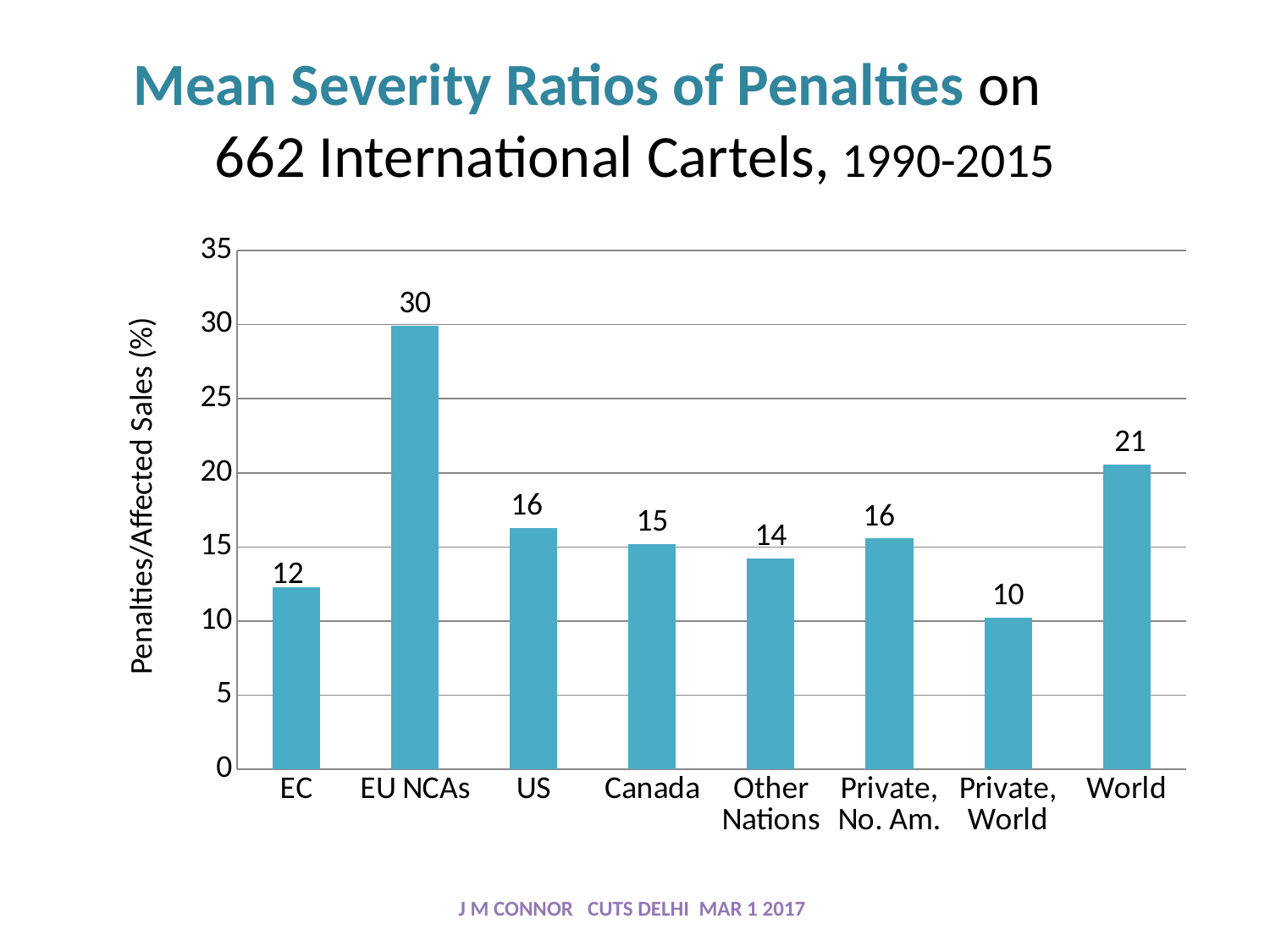
Which category has the highest mean severity ratio? EU NCAs What is the mean severity ratio for EU NCAs? 30 What is the value shown for Private, World? 10 Which category has the lowest mean severity ratio? Private, World Which is larger, the value for US or the value for Other Nations? US What is the label of the y axis? Penalties/Affected Sales (%) What is the difference between the values for World and Canada? 6 What is the value shown for World? 21 Is the value for World greater or less than 20? greater What is the difference between the values for EU NCAs and EC? 18 What kind of chart is shown on the slide? bar chart How many categories are shown on the x axis? 8